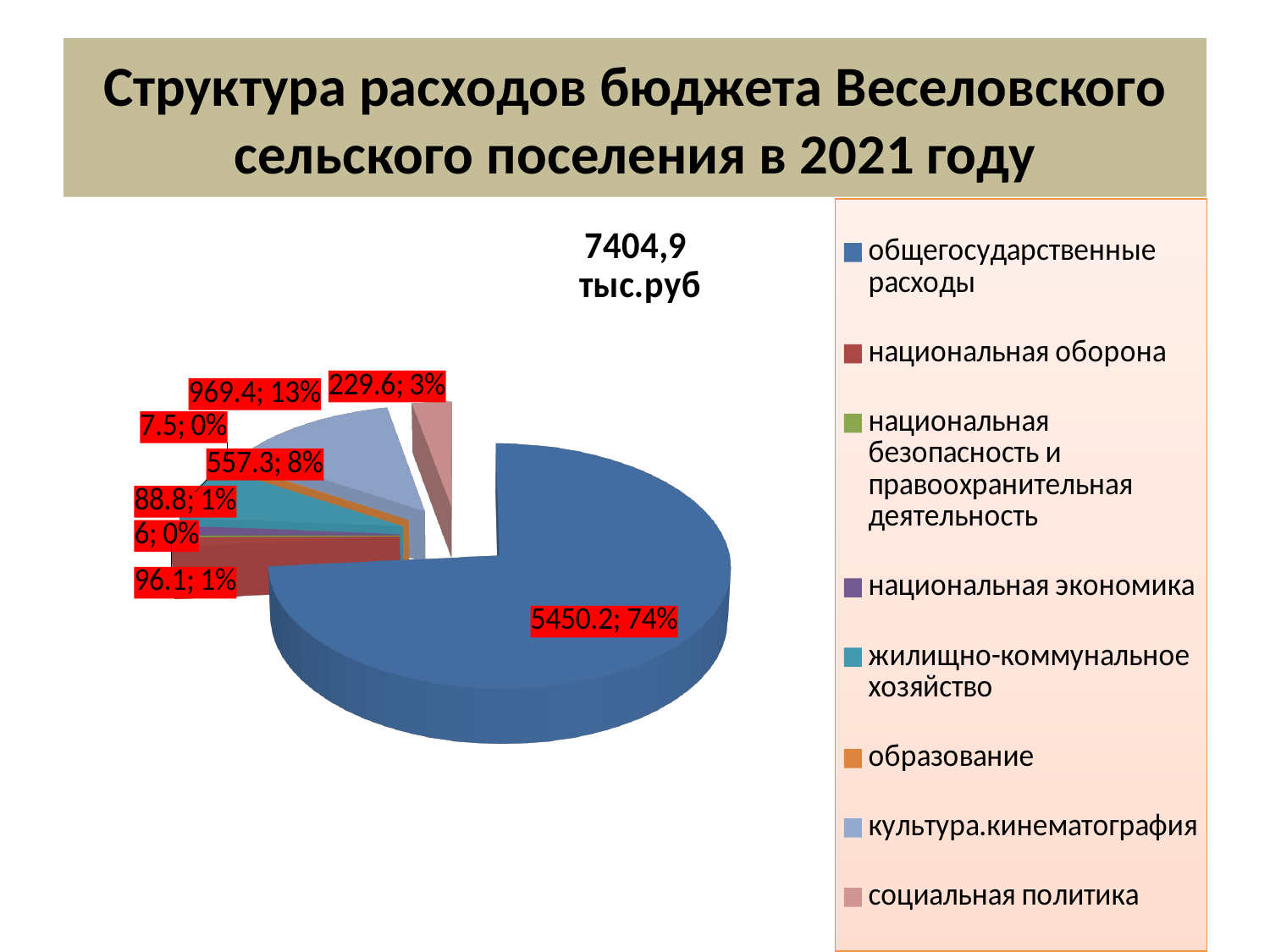
What is the value shown for общегосударственные расходы? 5450.2 What total amount is printed above the pie chart? 7404,9 тыс.руб Which is larger: культура.кинематография or жилищно-коммунальное хозяйство? культура.кинематография What is the value shown for социальная политика? 229.6 What share of the pie does жилищно-коммунальное хозяйство take? 8% Which category has the largest slice of the pie? общегосударственные расходы What share of the pie does общегосударственные расходы take? 74% What is the value shown for культура.кинематография? 969.4 What is the difference between the values for культура.кинематография and жилищно-коммунальное хозяйство? 412.1 What kind of chart is shown on the slide? pie chart How many slices does the pie chart have? 8 What is the value shown for национальная оборона? 96.1